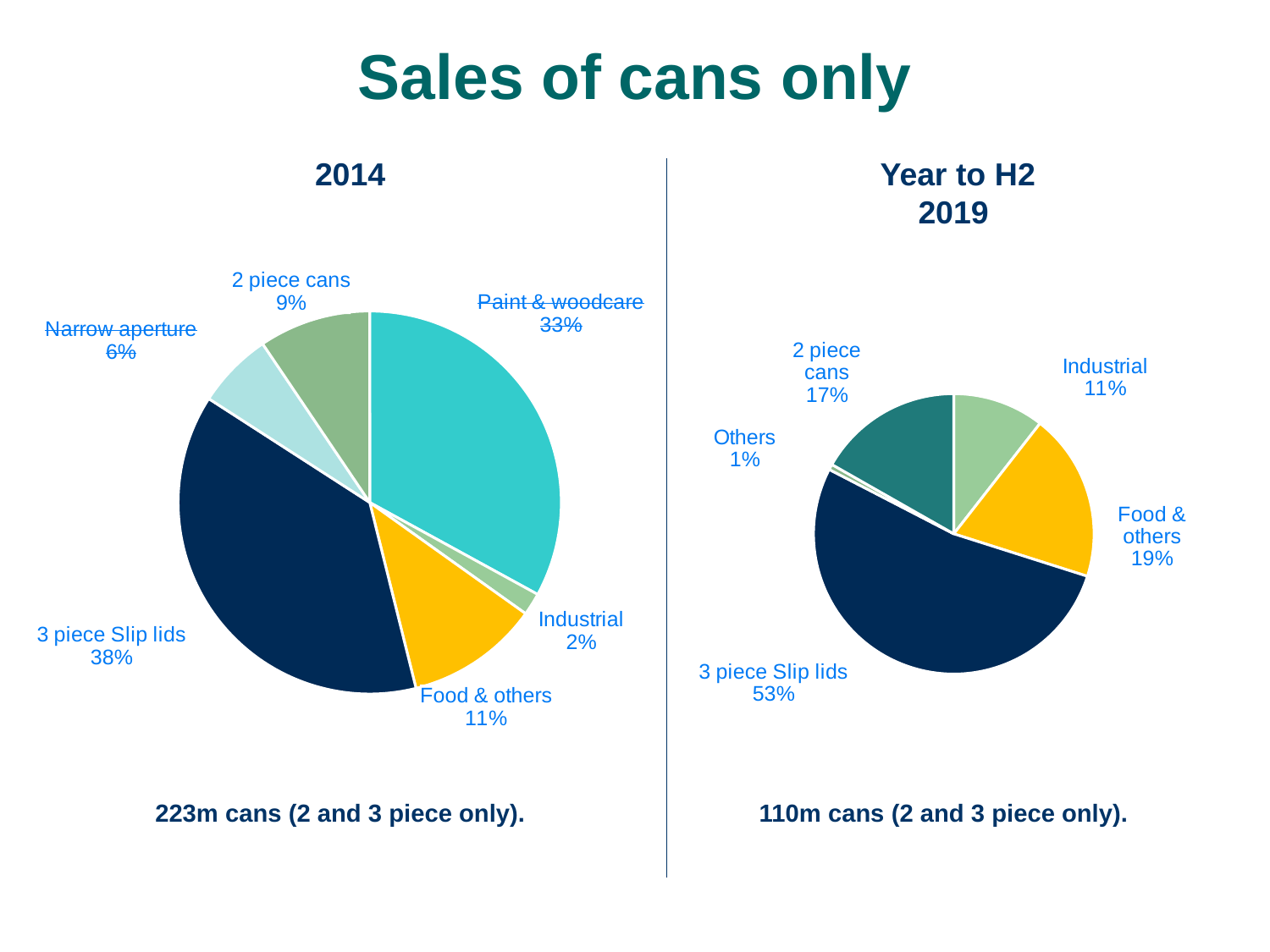
How many slices does the Year to H2 2019 pie chart have? 5 In the Year to H2 2019 chart, which category has the smallest share? Others In the 2014 chart, what is the difference between the shares of 2 piece cans and Narrow aperture? 3% In the 2014 chart, which category has the largest share? 3 piece Slip lids In the 2014 chart, which category has the smallest share? Industrial What is the title of the slide? Sales of cans only In the 2014 chart, what share does Paint & woodcare have? 33% In the 2014 chart, what share do 3 piece Slip lids have? 38% In the Year to H2 2019 chart, which is larger, Food & others or Industrial? Food & others In the Year to H2 2019 chart, what share do 3 piece Slip lids have? 53% How many slices does the 2014 pie chart have? 6 What kind of chart is the 2014 chart? Pie chart